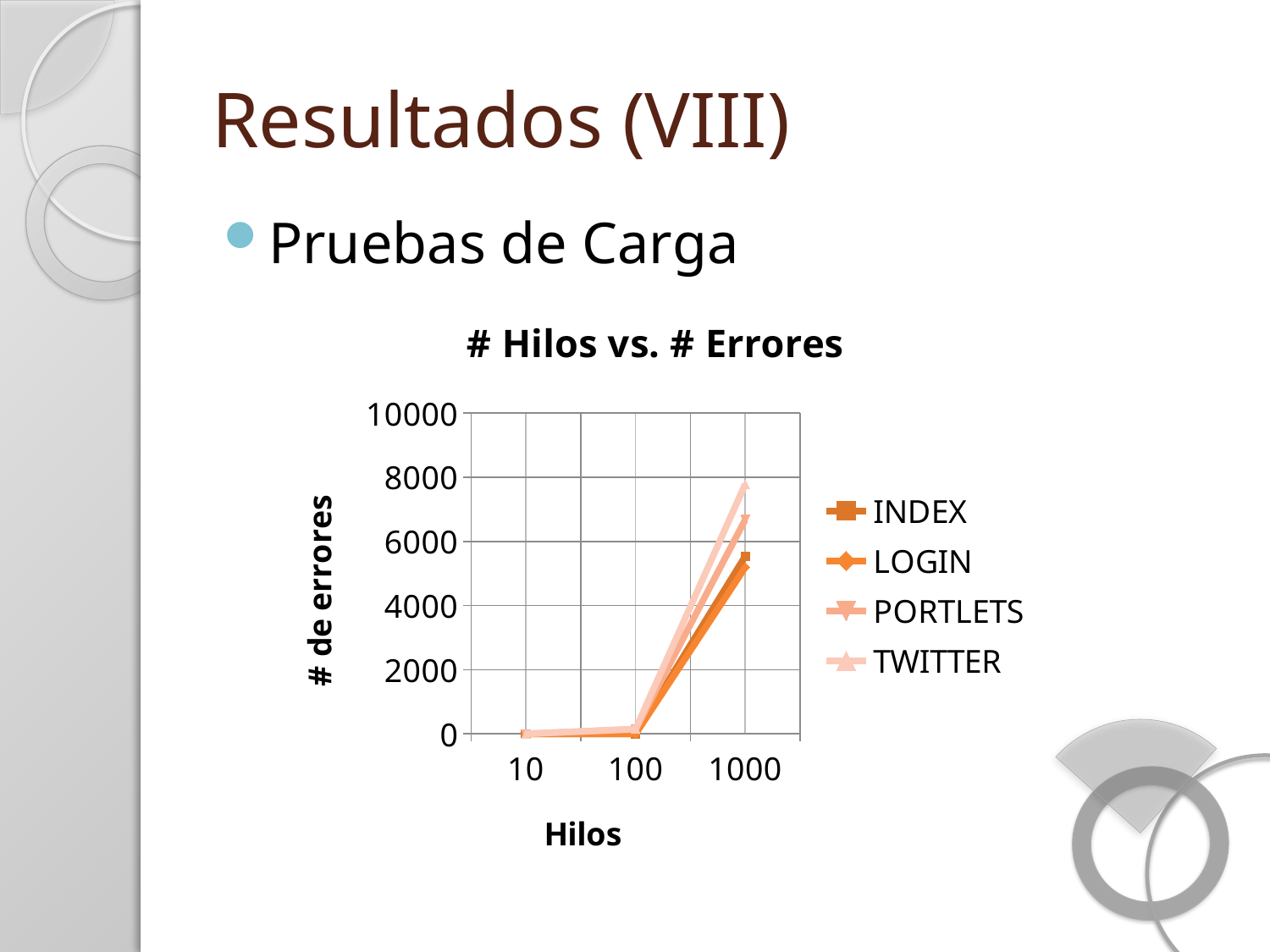
What is the title of the chart? # Hilos vs. # Errores At 1000 hilos, which is larger, the value for TWITTER or the value for PORTLETS? TWITTER Is the value for INDEX at 1000 hilos greater or less than 6000? less Is the value for LOGIN at 1000 hilos greater or less than 4000? greater How many points are plotted along the x axis for each series? 3 Is the value for PORTLETS at 100 hilos greater or less than 2000? less What is the label of the y axis? # de errores How many series does the legend list? 4 Which series has the highest number of errors at 1000 hilos? TWITTER Do the number of errors rise or fall as the number of hilos increases from 10 to 1000? rise What kind of chart is shown on the slide? line chart